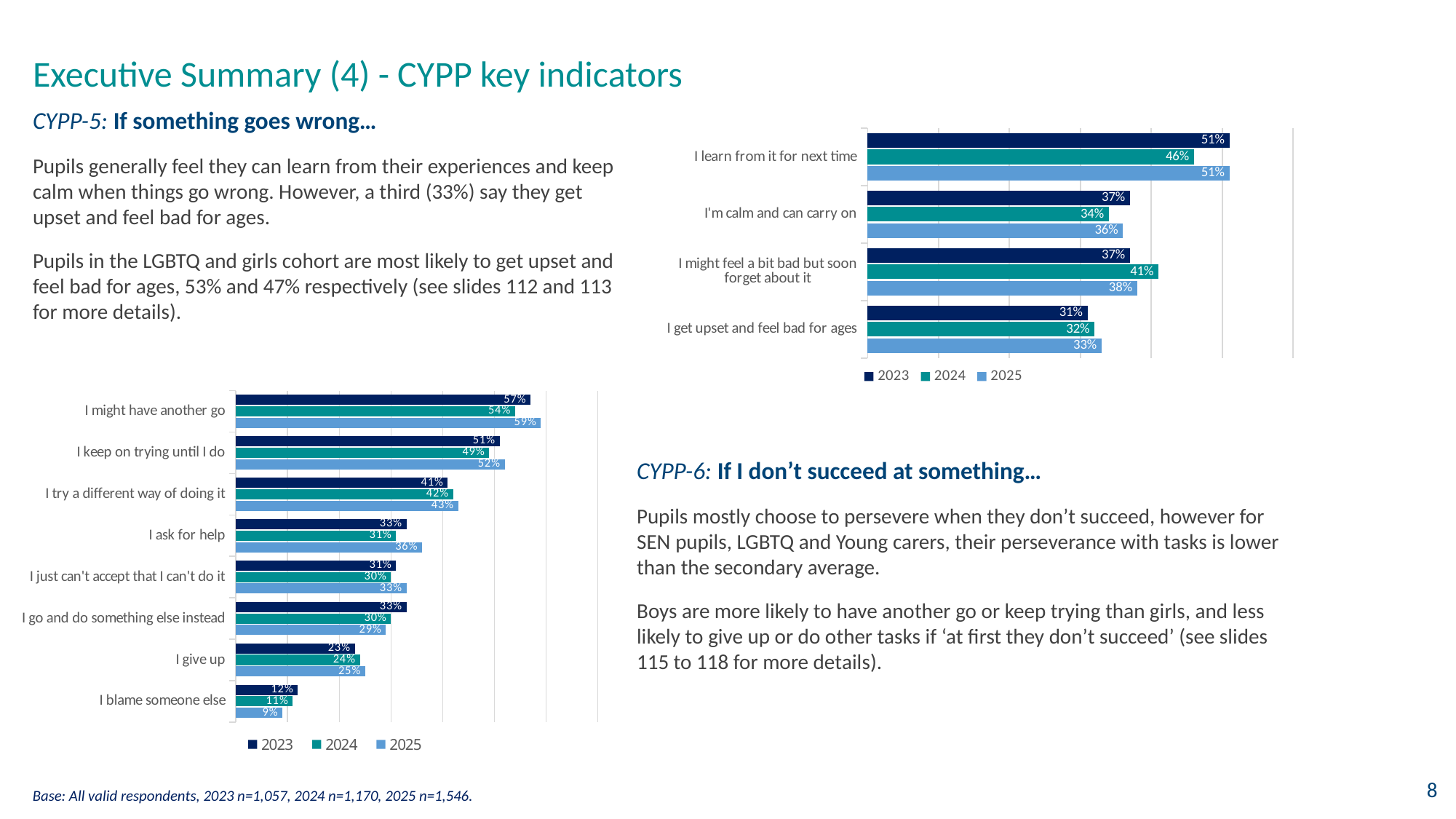
In the bottom-left chart, which colour represents 2024 in the legend? Teal In the top-right chart, what is the 2024 value for 'I learn from it for next time'? 46% In the top-right chart, how many series does the legend list? 3 In the bottom-left chart, is the 2025 value for 'I ask for help' larger or smaller than the 2025 value for 'I give up'? larger In the bottom-left chart, how many categories are shown? 8 What kind of chart is the bottom-left chart? Bar chart In the bottom-left chart, what is the difference between the 2025 and 2023 values for 'I keep on trying until I do'? 1 percentage point In the top-right chart, what is the difference between the 2024 and 2023 values for 'I might feel a bit bad but soon forget about it'? 4 percentage points In the top-right chart, which category has the highest 2023 value? I learn from it for next time In the bottom-left chart, which category has the lowest 2025 value? I blame someone else In the bottom-left chart, what is the 2025 value for 'I might have another go'? 59% In the top-right chart, what is the 2025 value for 'I get upset and feel bad for ages'? 33%